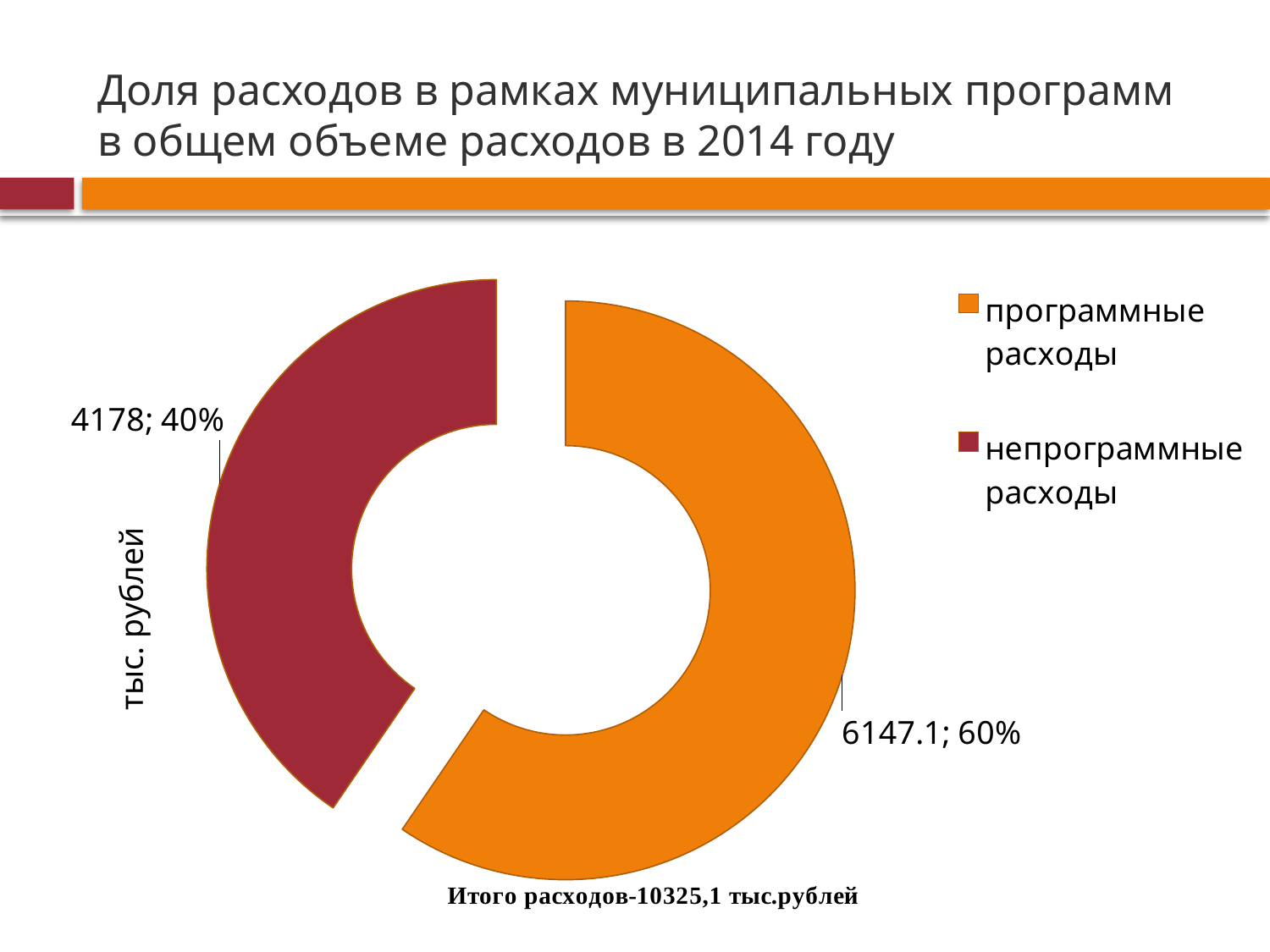
What is the difference between программные расходы and непрограммные расходы? 1969.1 Which is larger, программные расходы or непрограммные расходы? программные расходы What total expenses figure is printed below the chart? 10325,1 тыс.рублей What kind of chart is shown on the slide? doughnut chart What value is shown for программные расходы? 6147.1 What value is shown for непрограммные расходы? 4178 Which category has the largest value? программные расходы What share of total expenses do программные расходы make up? 60% What share of total expenses do непрограммные расходы make up? 40% How many categories does the chart show? 2 What colour represents непрограммные расходы in the chart? dark red Which category has the smallest value? непрограммные расходы